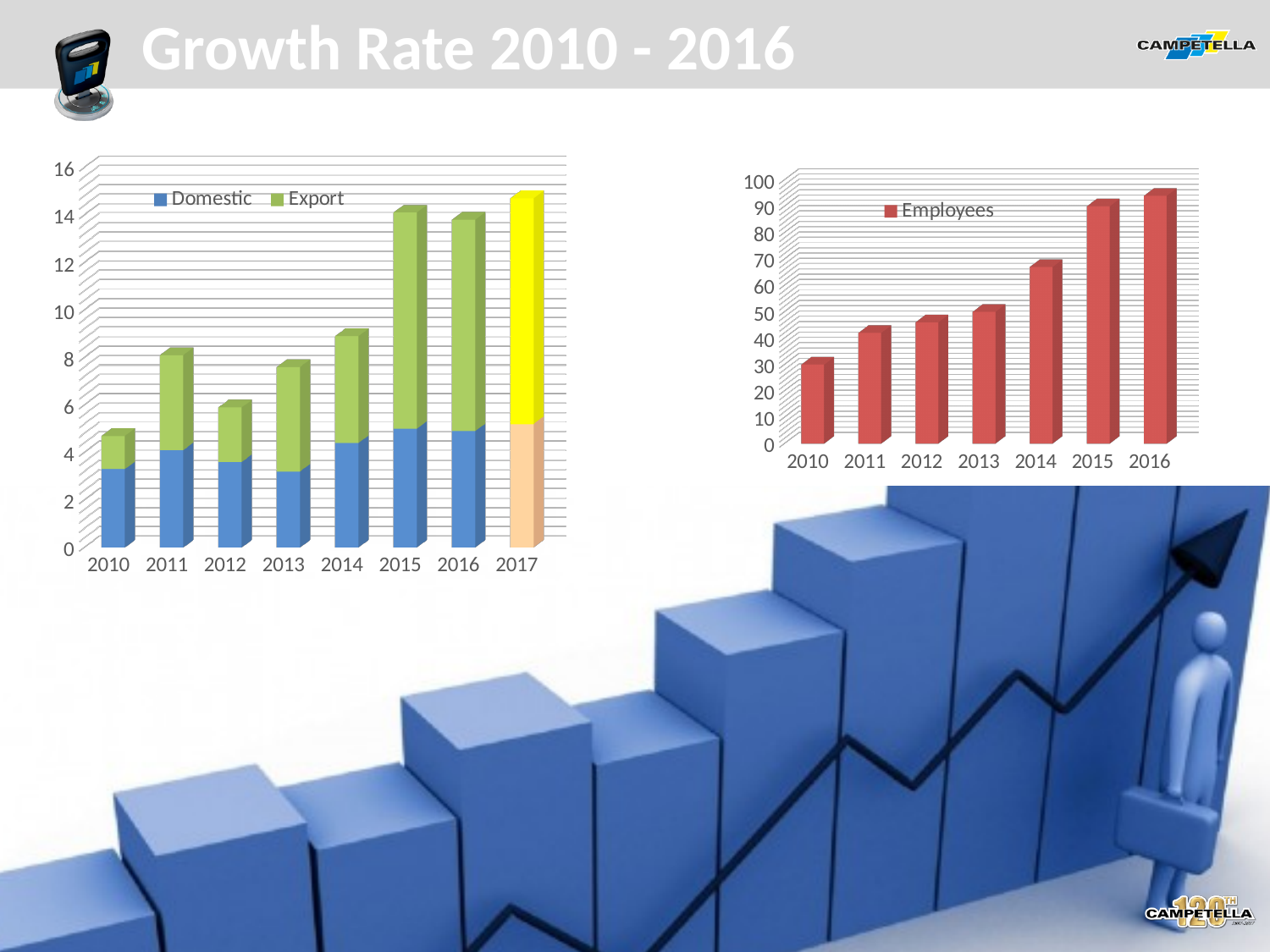
In the right chart 'Employees', is the value for 2010 greater or less than 40? less In the right chart 'Employees', which year has the highest value? 2016 In the left chart with Domestic and Export, which year has the lowest total bar? 2010 In the right chart 'Employees', is the value for 2015 greater or less than 80? greater In the left chart with Domestic and Export, is the total bar for 2015 greater or less than 12? greater In the left chart with Domestic and Export, is the total bar for 2015 larger or smaller than the total bar for 2014? larger In the right chart 'Employees', do the values generally rise or fall from 2010 to 2016? rise What kind of chart is the chart on the right titled 'Employees'? bar chart In the left chart with Domestic and Export, how many years are shown on the x axis? 8 In the right chart 'Employees', how many years are shown on the x axis? 7 In the right chart 'Employees', which year has the lowest value? 2010 In the left chart with Domestic and Export, how many series does the legend list? 2